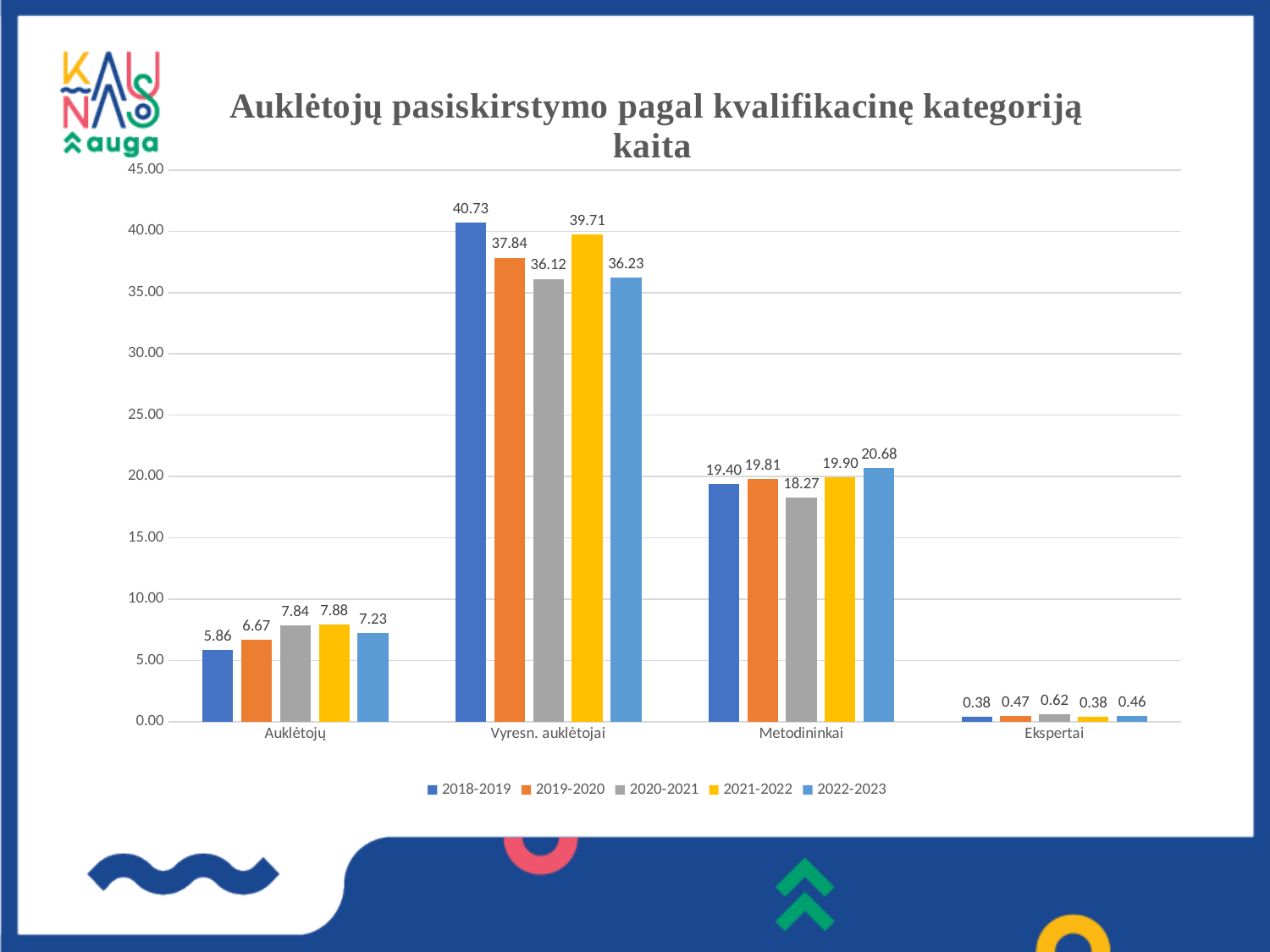
What is the value for Vyresn. auklėtojai in 2018-2019? 40.73 Which category has the lowest value in 2019-2020? Ekspertai What is the value for Ekspertai in 2020-2021? 0.62 Which category has the highest value in 2021-2022? Vyresn. auklėtojai What kind of chart is shown on the slide? bar chart What is the difference between the 2018-2019 and 2022-2023 values for Vyresn. auklėtojai? 4.50 How many categories are shown on the x axis? 4 Is the value for Metodininkai in 2020-2021 greater or less than 20.00? less What is the value for Metodininkai in 2022-2023? 20.68 Which colour represents the 2021-2022 series? yellow How many series does the legend list? 5 Which is larger for Auklėtojų: the 2020-2021 value or the 2022-2023 value? 2020-2021